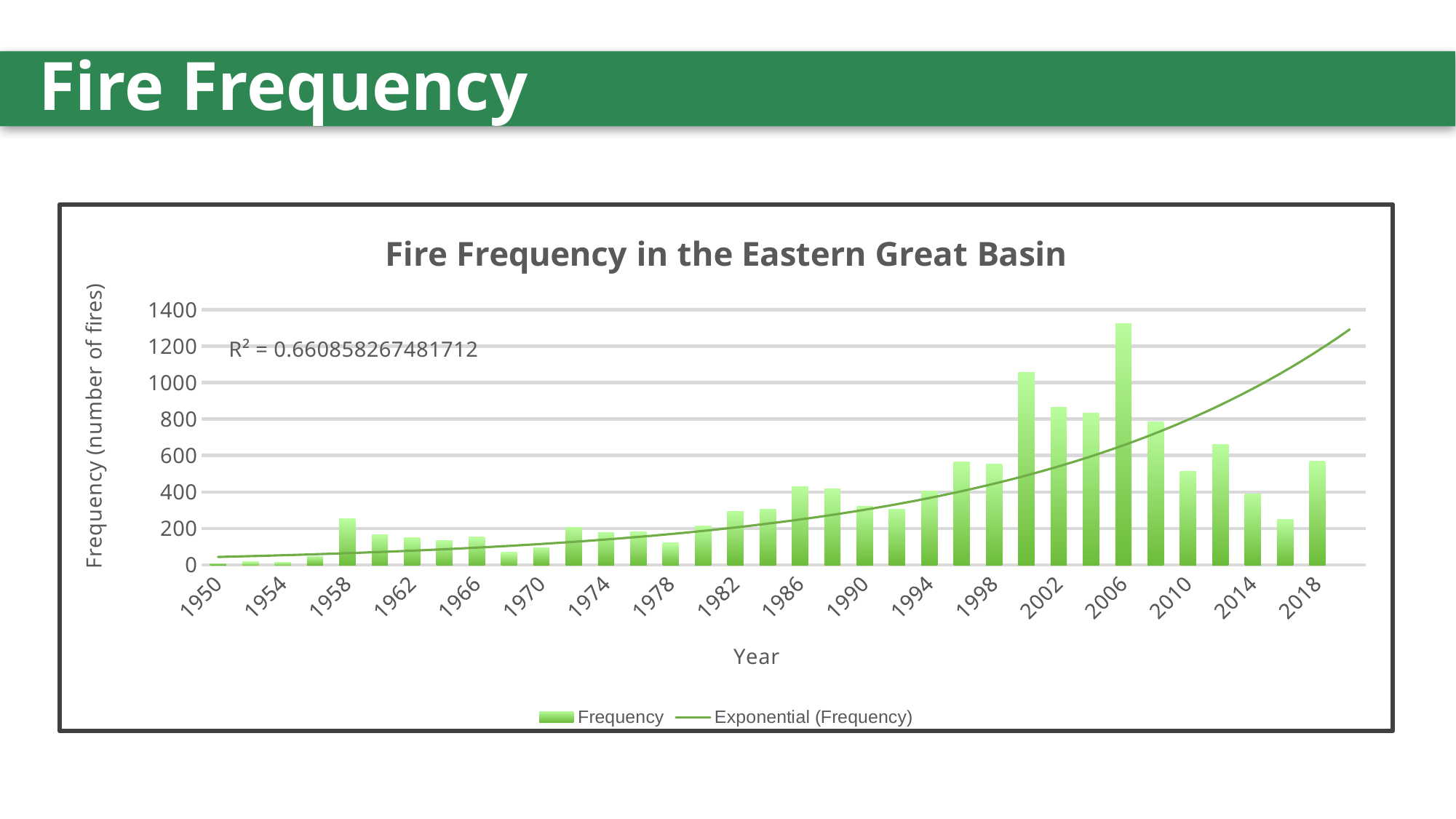
Which year has the highest fire frequency? 2006 Is the value for 2014 greater or less than 600? less How many series does the legend list? 2 Overall, do fire frequency values rise or fall from 1950 to 2018? rise Which year has the larger fire frequency, 2000 or 2002? 2000 What is the title of the chart? Fire Frequency in the Eastern Great Basin Is the value for 1970 greater or less than 200? less Is the value for 2018 greater or less than 400? greater What type of chart is shown on the slide? Bar chart What is the label of the y axis? Frequency (number of fires)